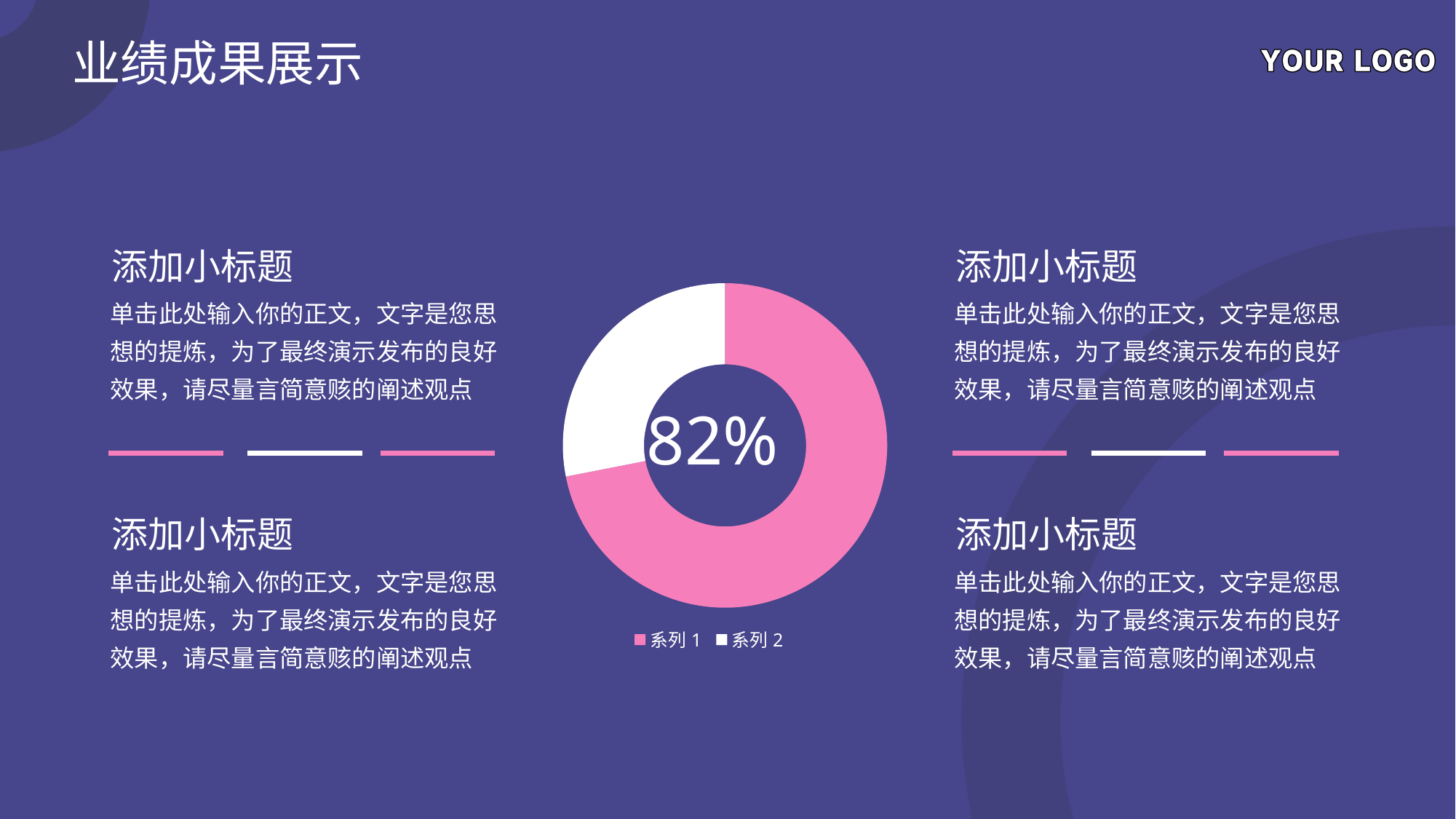
How many slices does the doughnut chart have? 2 Which series has the largest slice in the doughnut chart? 系列 1 Does the slice for 系列 1 take up more or less than half of the doughnut chart? more What percentage is displayed in the centre of the doughnut chart? 82% Which slice is larger, 系列 1 or 系列 2? 系列 1 What colour is the slice for 系列 1 in the doughnut chart? pink What kind of chart is shown on the slide? doughnut chart How many series does the legend of the chart list? 2 Which series has the smallest slice in the doughnut chart? 系列 2